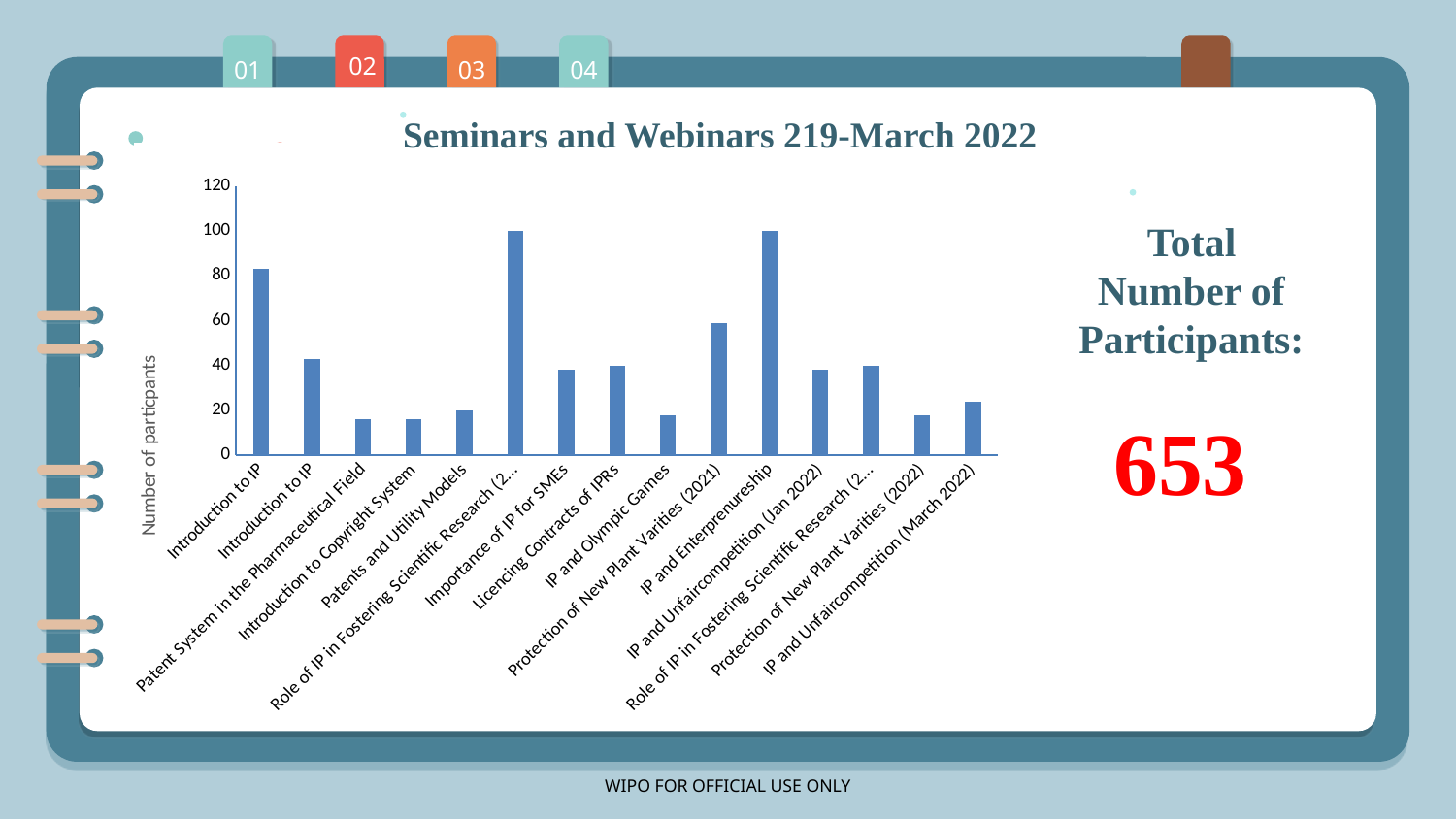
Which has more participants: IP and Enterprenureship or IP and Olympic Games? IP and Enterprenureship Is the value for IP and Unfaircompetition (March 2022) greater or less than 40? less What is the title of the chart? Seminars and Webinars 219-March 2022 Is the value for Protection of New Plant Varities (2021) greater or less than 40? greater How many bars (seminar/webinar categories) are plotted in the chart? 15 Which has more participants: IP and Unfaircompetition (Jan 2022) or IP and Unfaircompetition (March 2022)? IP and Unfaircompetition (Jan 2022) Which has more participants: Protection of New Plant Varities (2021) or Protection of New Plant Varities (2022)? Protection of New Plant Varities (2021) Is the value for Licencing Contracts of IPRs greater or less than 20? greater What is the label on the vertical axis of the chart? Number of particpants What kind of chart is shown on the slide? bar chart